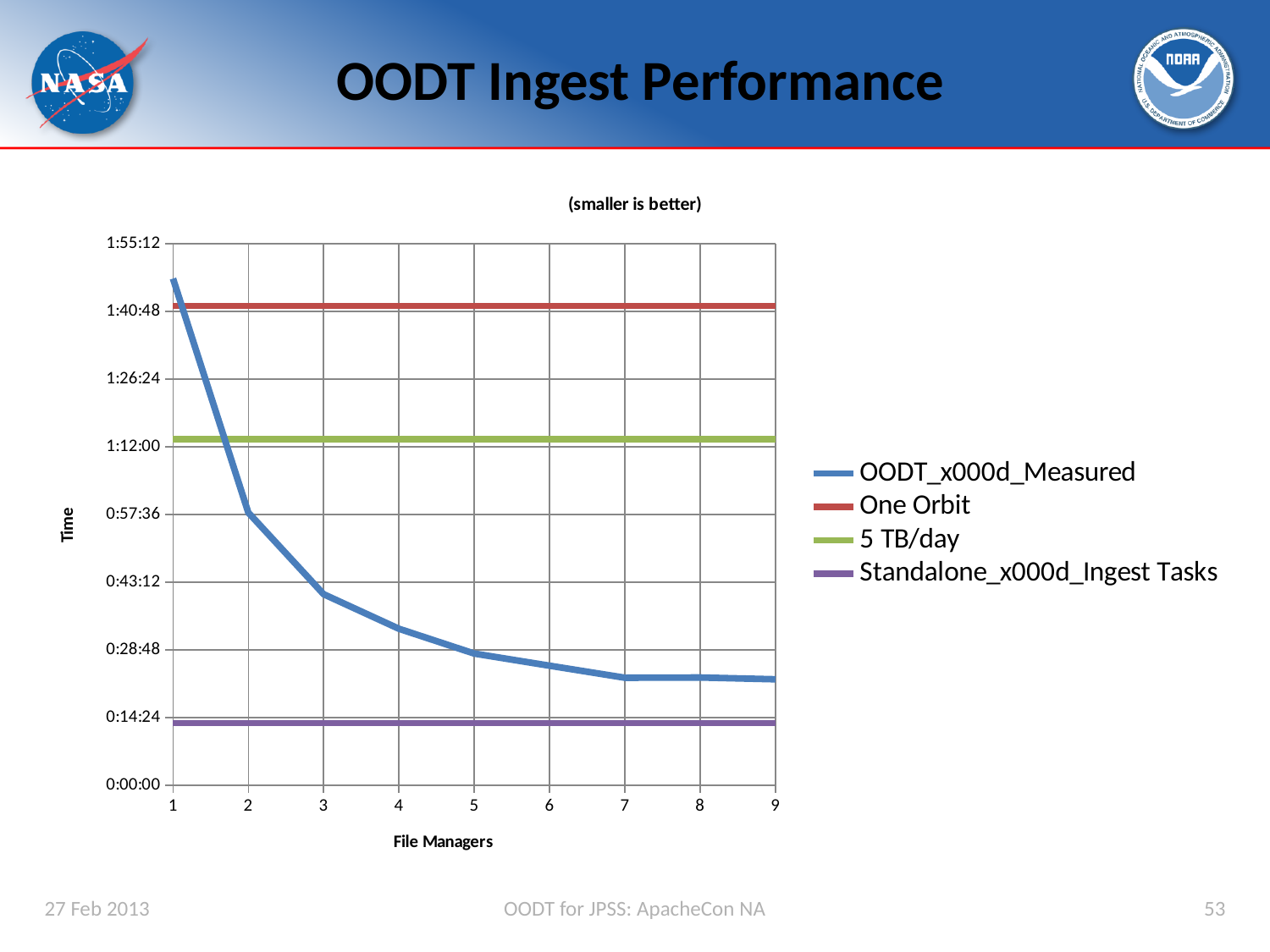
How many series does the legend list? 4 At which number of File Managers is the OODT_x000d_Measured time highest? 1 Which of the flat reference lines is the highest: One Orbit, 5 TB/day, or Standalone_x000d_Ingest Tasks? One Orbit At 9 File Managers, which is larger: OODT_x000d_Measured or Standalone_x000d_Ingest Tasks? OODT_x000d_Measured How many File Managers values are plotted along the x axis? 9 Is the Standalone_x000d_Ingest Tasks line greater or less than 0:28:48? less Is the OODT_x000d_Measured value at 9 File Managers greater or less than 0:14:24? greater Is the OODT_x000d_Measured value at 3 File Managers greater or less than 0:43:12? less Does the OODT_x000d_Measured series rise or fall as the number of File Managers increases? fall What kind of chart is shown on the slide? line chart What is the label of the x axis? File Managers